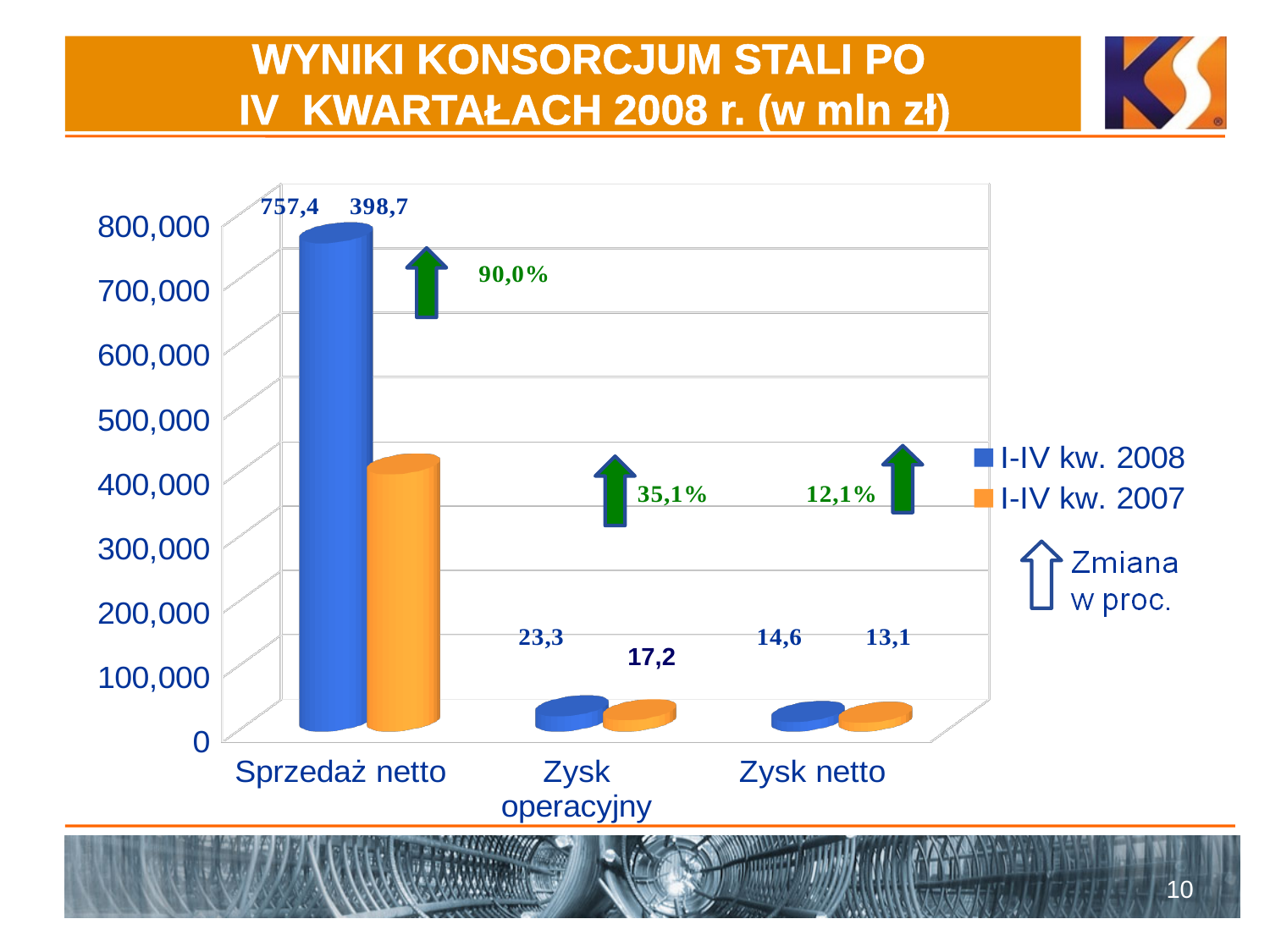
Which is larger for Zysk netto: the I-IV kw. 2008 value or the I-IV kw. 2007 value? I-IV kw. 2008 Which category has the highest value in the I-IV kw. 2008 series? Sprzedaż netto What is the value for Sprzedaż netto in the I-IV kw. 2007 series? 398,7 What is the difference between the I-IV kw. 2008 and I-IV kw. 2007 values for Zysk operacyjny? 6,1 How many categories are shown on the x axis of the chart? 3 What percentage change is shown above the Sprzedaż netto bars? 90,0% How many data series does the legend list? 2 What is the value for Zysk netto in the I-IV kw. 2007 series? 13,1 Which category has the lowest value in the I-IV kw. 2007 series? Zysk netto What is the value for Sprzedaż netto in the I-IV kw. 2008 series? 757,4 What is the difference between the I-IV kw. 2008 and I-IV kw. 2007 values for Sprzedaż netto? 358,7 What is the value for Zysk operacyjny in the I-IV kw. 2008 series? 23,3